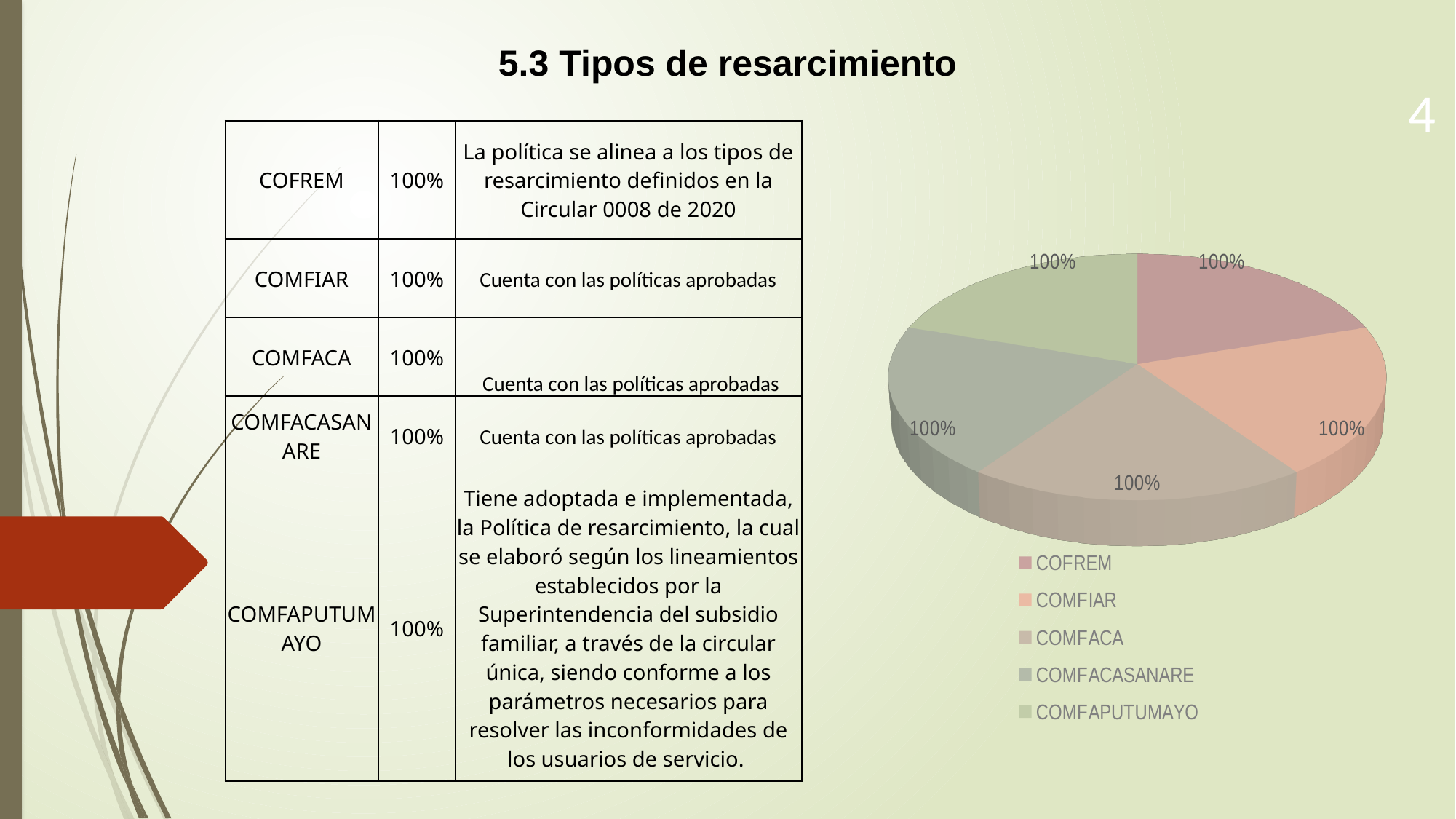
What value is labelled on the COFREM slice of the pie chart? 100% What value is labelled on the COMFAPUTUMAYO slice of the pie chart? 100% What kind of chart is shown on the slide? pie chart How many slices does the pie chart have? 5 What is the difference between the values labelled for COMFACA and COMFAPUTUMAYO? 0% What value is labelled on the COMFACA slice of the pie chart? 100% Is the value labelled for COFREM larger than, smaller than, or equal to the value labelled for COMFIAR? equal Which legend entry is listed last in the pie chart's legend? COMFAPUTUMAYO Which legend entry is listed first in the pie chart's legend? COFREM How many entries does the pie chart's legend list? 5 What value is labelled on the COMFIAR slice of the pie chart? 100% What value is labelled on the COMFACASANARE slice of the pie chart? 100%